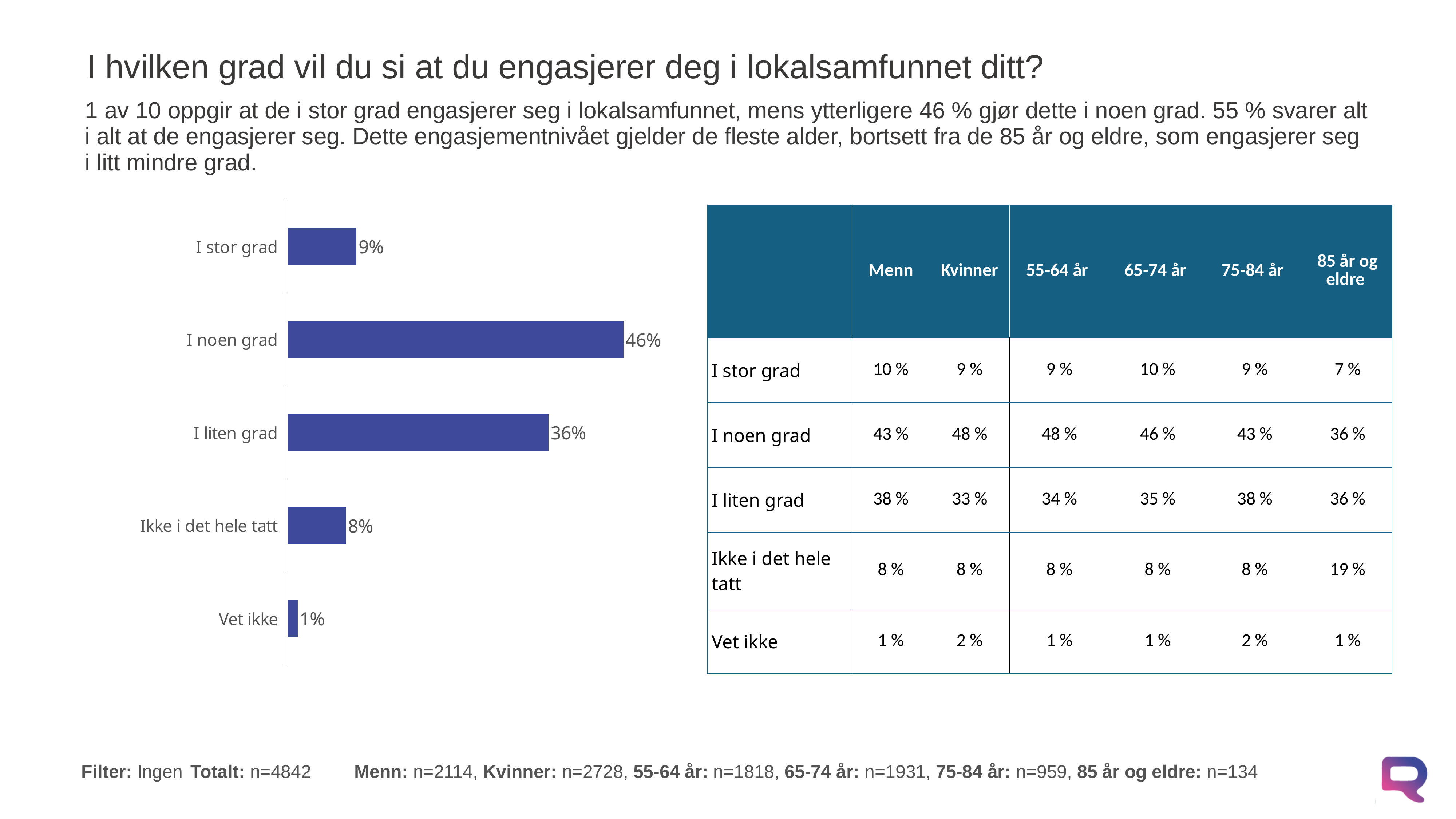
What colour are the bars in the bar chart? Blue What is the value for "Ikke i det hele tatt" in the bar chart? 8% What is the difference between the values for "I stor grad" and "Ikke i det hele tatt" in the bar chart? 1% Which is larger in the bar chart, the value for "I liten grad" or the value for "I stor grad"? I liten grad Which category has the highest value in the bar chart? I noen grad How many categories are shown in the bar chart? 5 What is the value for "Vet ikke" in the bar chart? 1% What kind of chart is shown on the slide? Bar chart What is the value for "I stor grad" in the bar chart? 9% What is the difference between the values for "I noen grad" and "I liten grad" in the bar chart? 10% What is the value for "I noen grad" in the bar chart? 46% Which category has the lowest value in the bar chart? Vet ikke